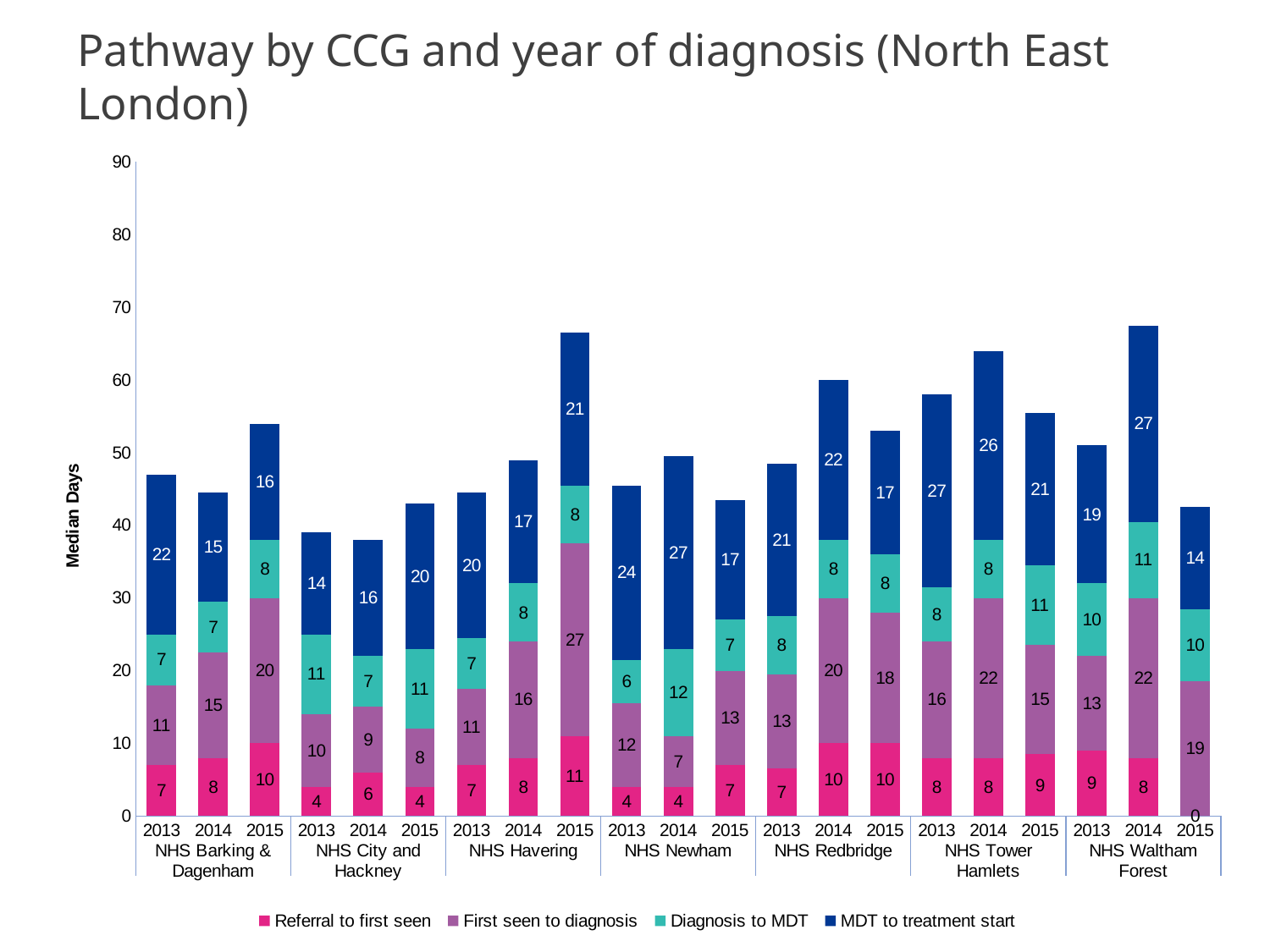
What is the value of Diagnosis to MDT for NHS City and Hackney in 2013? 11 What is the difference in MDT to treatment start between NHS Newham 2014 and NHS Newham 2015? 10 What is the total median days for the NHS Redbridge 2014 bar? 60 Which CCG and year has the lowest Referral to first seen value? NHS Waltham Forest 2015 What is the value of MDT to treatment start for NHS Havering in 2015? 21 How many series does the legend list? 4 Which CCG and year has the highest First seen to diagnosis value? NHS Havering 2015 How many CCGs are shown on the x axis? 7 Which has the larger Diagnosis to MDT value: NHS Newham 2014 or NHS Havering 2014? NHS Newham 2014 Does the Referral to first seen value for NHS Barking & Dagenham rise or fall from 2013 to 2015? rise What is the value of First seen to diagnosis for NHS Tower Hamlets in 2014? 22 What is the total median days for the NHS Barking & Dagenham 2013 bar? 47